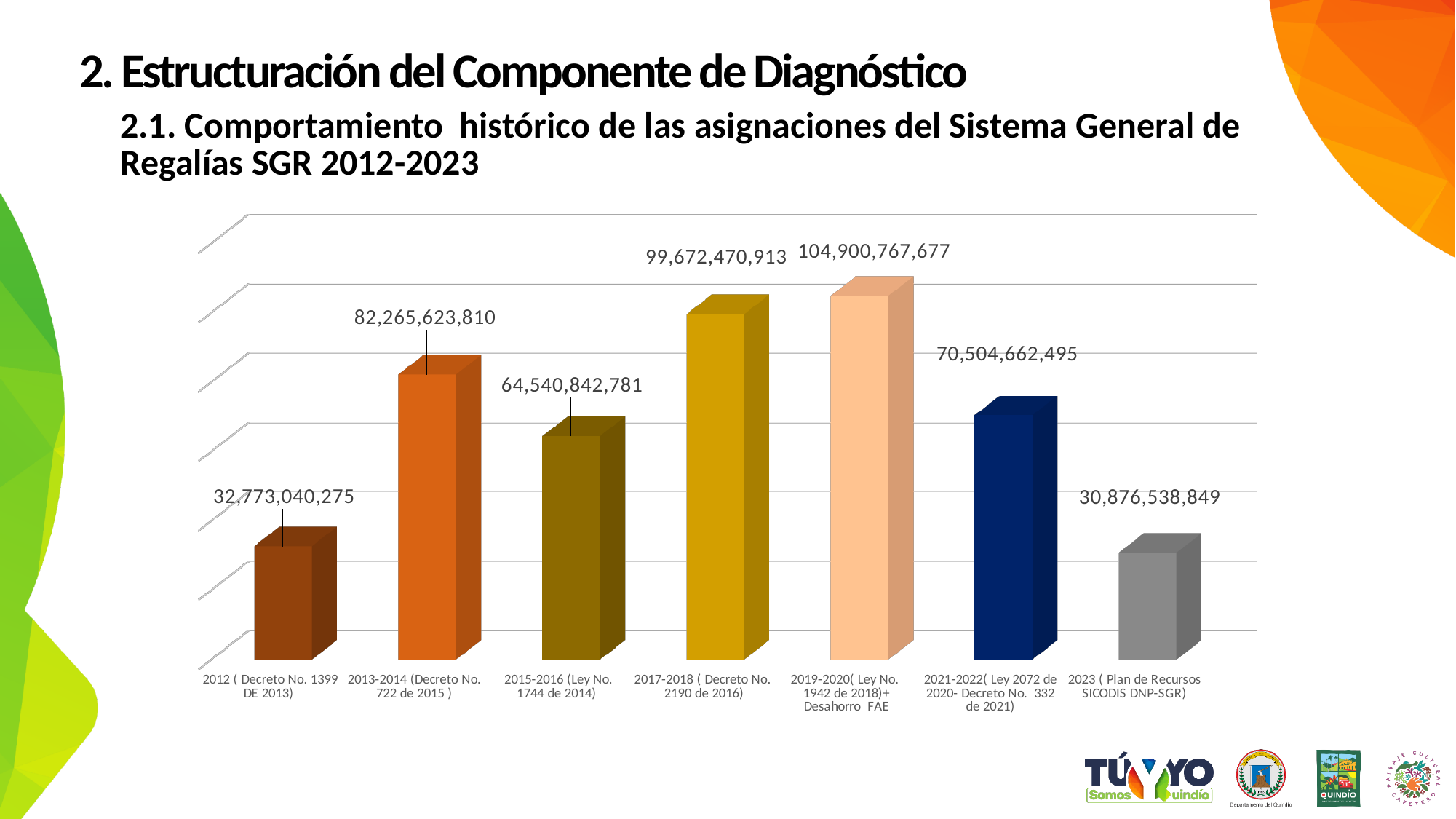
What is the difference between the values for 2013-2014 and 2015-2016? 17,724,781,029 Which period has the highest value? 2019-2020 (Ley No. 1942 de 2018) + Desahorro FAE What is the value for 2021-2022 (Ley 2072 de 2020 - Decreto No. 332 de 2021)? 70,504,662,495 What is the value for 2023 (Plan de Recursos SICODIS DNP-SGR)? 30,876,538,849 What is the value for 2012 (Decreto No. 1399 DE 2013)? 32,773,040,275 Which is larger, the value for 2013-2014 or the value for 2021-2022? 2013-2014 How many periods (bars) are shown in the chart? 7 Do the values rise or fall from 2019-2020 to 2023? Fall What kind of chart is shown on the slide? Bar chart What is the value for 2017-2018 (Decreto No. 2190 de 2016)? 99,672,470,913 What is the difference between the values for 2019-2020 and 2017-2018? 5,228,296,764 Which period has the lowest value? 2023 (Plan de Recursos SICODIS DNP-SGR)